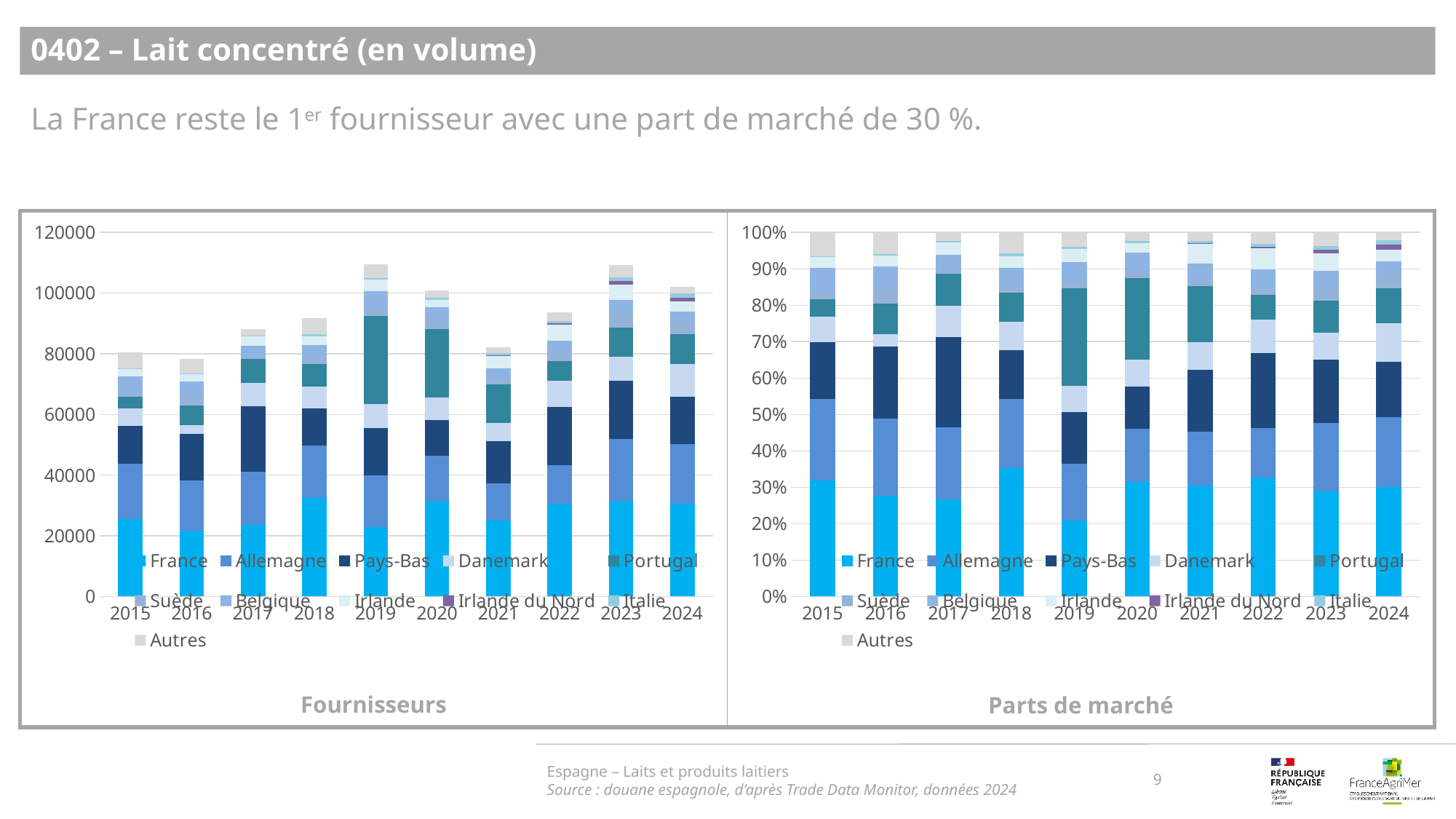
In the 'Parts de marché' chart, is the share of France in 2019 greater or less than 30%? less In the 'Fournisseurs' chart, is the total stacked bar for 2022 greater or less than 100000? less What is the title of the chart on the right of the slide? Parts de marché What kind of chart is the 'Fournisseurs' chart on the left? Stacked bar chart In the 'Fournisseurs' chart, which total bar is larger, 2019 or 2021? 2019 In the 'Parts de marché' chart, is the share of France in 2018 greater or less than 30%? greater In the 'Parts de marché' chart, which year has the larger share for France, 2018 or 2019? 2018 How many series does the legend of the 'Parts de marché' chart list? 11 Which series is listed first in the legend of the 'Fournisseurs' chart? France How many years are shown on the x axis of the 'Fournisseurs' chart? 10